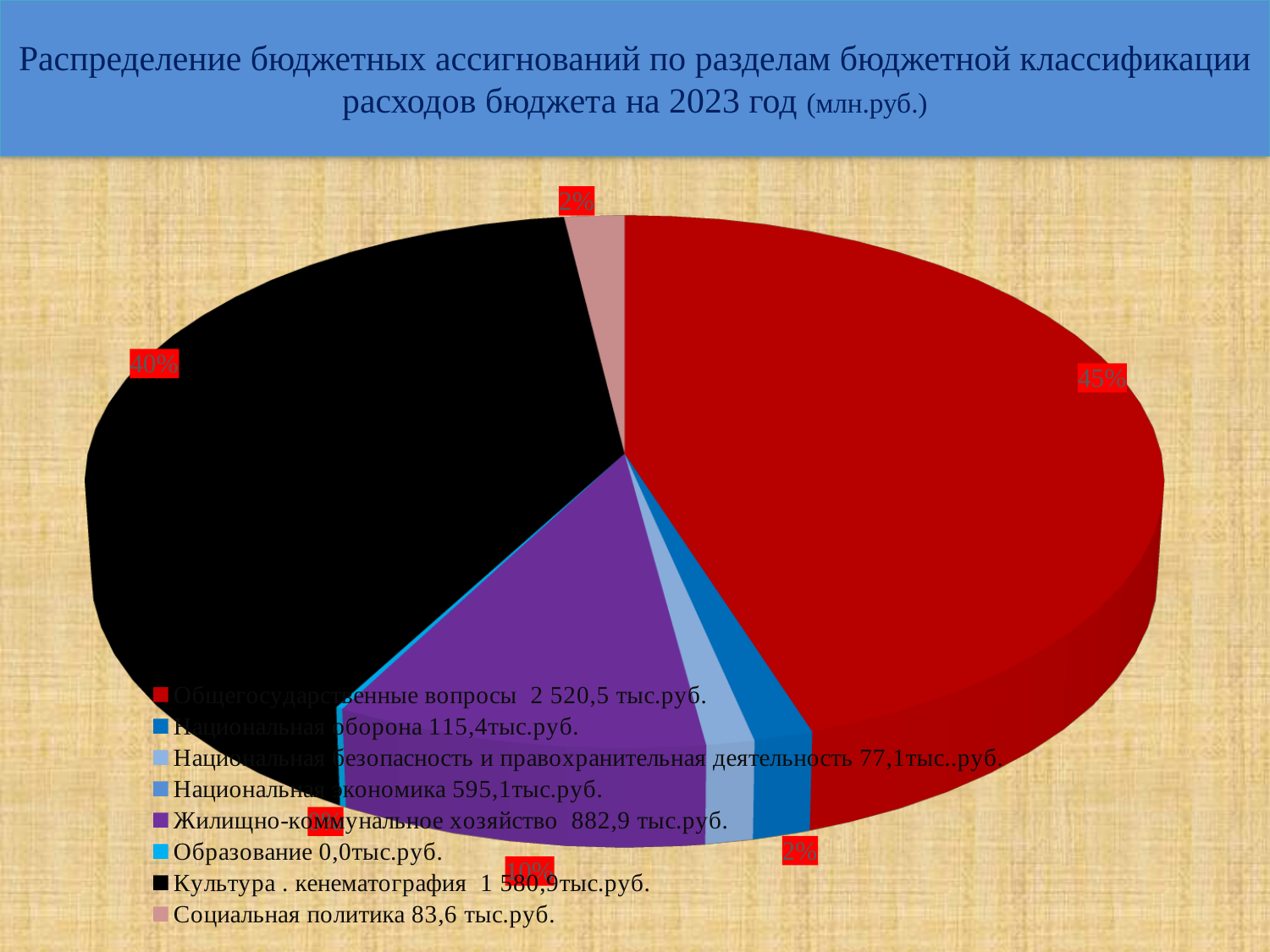
How many categories does the legend of the pie chart list? 8 What value is given in the legend for Образование? 0,0тыс.руб. What value is given in the legend for Жилищно-коммунальное хозяйство? 882,9 тыс.руб. What share of the pie does Культура, кинематография take? 40% Which category has the largest slice of the pie? Общегосударственные вопросы What value is given in the legend for Национальная экономика? 595,1тыс.руб. Which slice is larger: Общегосударственные вопросы or Культура, кинематография? Общегосударственные вопросы What kind of chart is shown on the slide? pie chart What value is given in the legend for Социальная политика? 83,6 тыс.руб. What share of the pie does Общегосударственные вопросы take? 45% What colour is the slice for Культура, кинематография? black By how many percentage points does the share of Общегосударственные вопросы exceed that of Культура, кинематография? 5